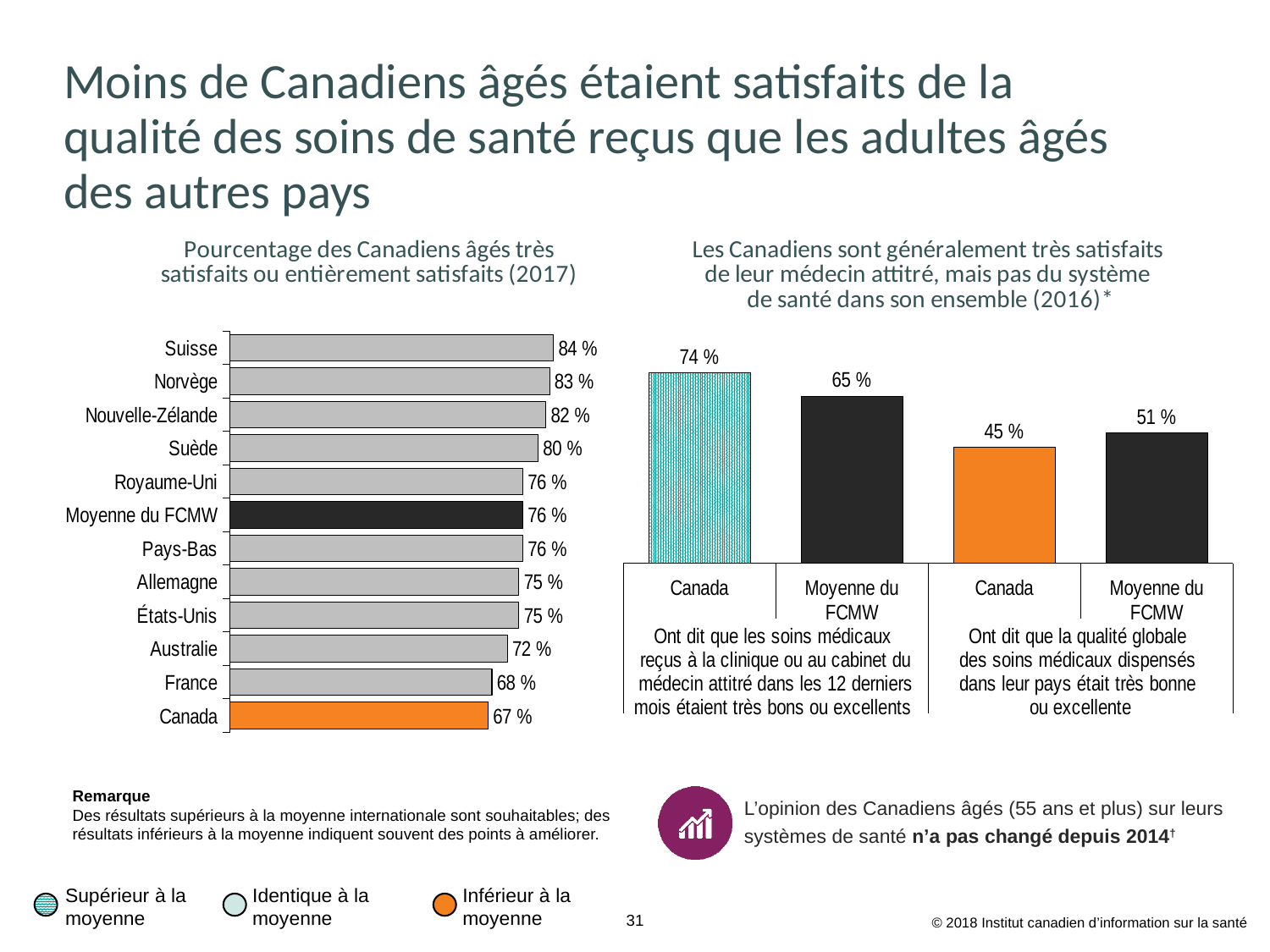
In the right chart (Les Canadiens sont généralement très satisfaits de leur médecin attitré, mais pas du système de santé dans son ensemble (2016)), what is the value for Canada for those who said the overall quality of medical care in their country was very good or excellent? 45 % What kind of chart is the left chart? Bar chart In the left chart, what colour is the bar for Canada? Orange In the left chart, which is larger, the value for France or the value for Australie? Australie In the left chart (Pourcentage des Canadiens âgés très satisfaits ou entièrement satisfaits (2017)), what is the value for Canada? 67 % In the left chart, which country has the highest value? Suisse In the left chart, what is the value for Suisse? 84 % How many countries or categories are shown in the left chart? 12 In the left chart, which country has the lowest value? Canada In the right chart, what is the difference between Canada and Moyenne du FCMW for those who said the medical care received at their regular doctor's clinic or office was very good or excellent? 9 % In the right chart, what is the value for Moyenne du FCMW for those who said the medical care received at their regular doctor's clinic or office in the last 12 months was very good or excellent? 65 % In the left chart, what is the difference between the value for Moyenne du FCMW and the value for Canada? 9 %